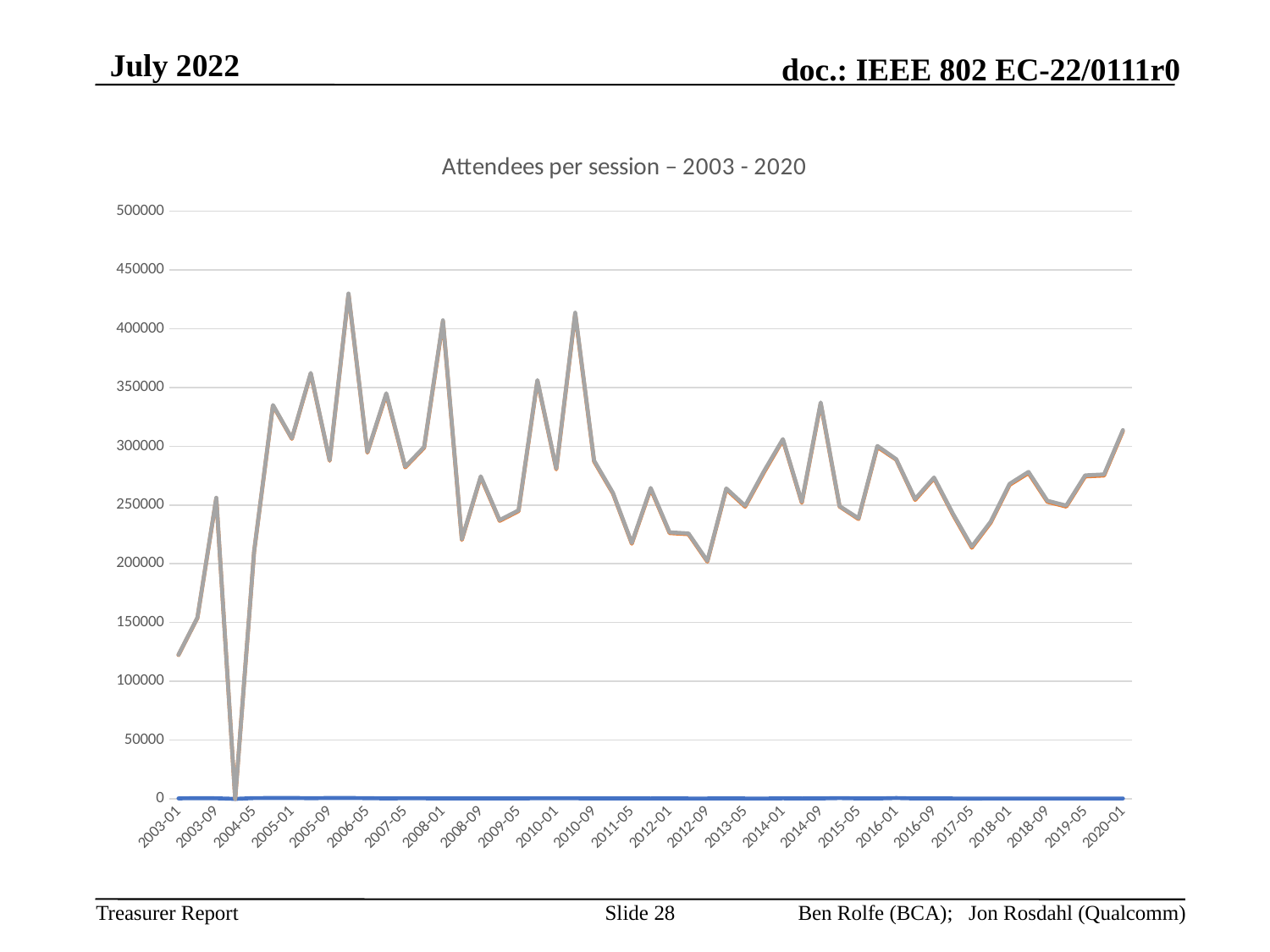
What kind of chart is shown on the slide? line chart Is the value for 2003-01 greater or less than 100000? greater What is the title of the chart? Attendees per session – 2003 - 2020 Is the value for 2020-01 greater or less than 300000? greater Is the value for 2003-01 greater or less than 150000? less Which is larger, the value for 2006-05 or the value for 2003-01? 2006-05 What is the highest value shown on the y axis of the chart? 500000 Does the value rise or fall from 2003-01 to 2003-09? rise